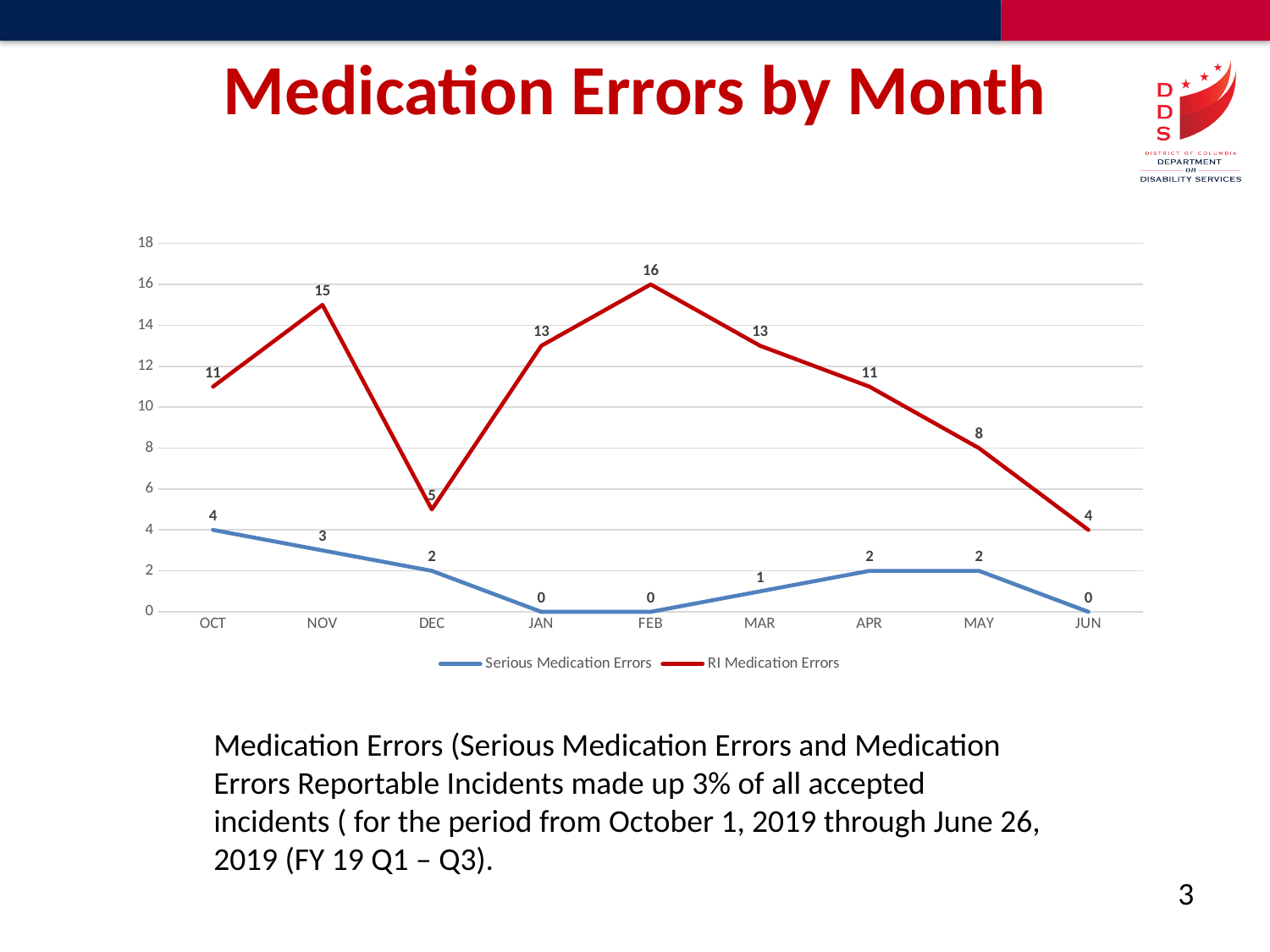
In which month are RI Medication Errors highest? FEB What is the value of RI Medication Errors in FEB? 16 In which month are RI Medication Errors lowest? JUN What type of chart is shown on the slide? Line chart Do RI Medication Errors rise or fall from FEB to JUN? Fall What colour is the line for Serious Medication Errors? Blue How many series does the legend list? 2 Is the value of RI Medication Errors in APR greater or less than 10? greater What is the difference between RI Medication Errors in NOV and DEC? 10 What is the value of Serious Medication Errors in OCT? 4 How many months are plotted on the x axis? 9 Which is larger: RI Medication Errors in JAN or in MAR? They are equal (13)